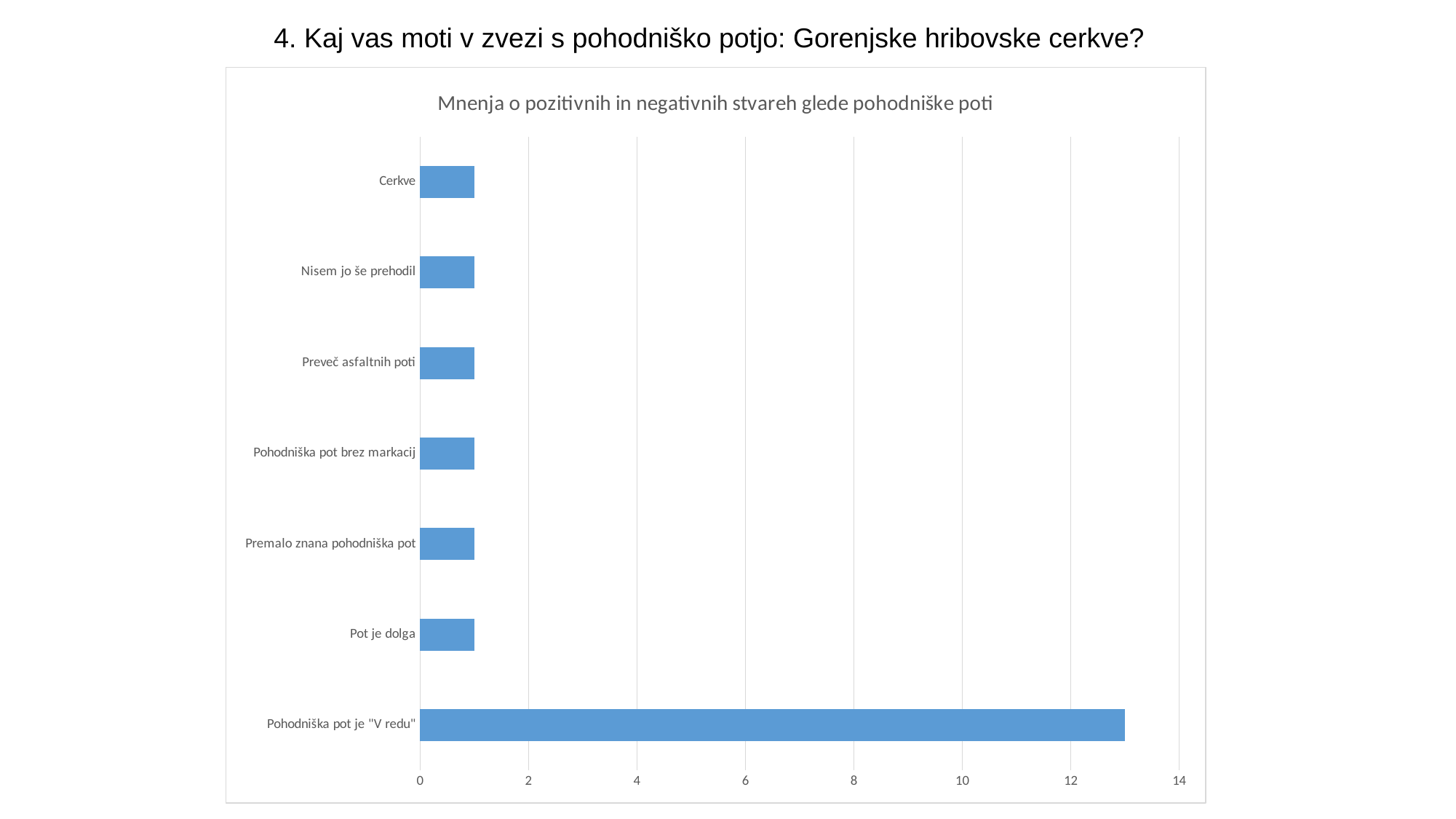
Is the value for Pot je dolga greater or less than 2? less Is the value for Cerkve greater or less than 2? less Is the value for Pohodniška pot je "V redu" greater or less than 12? greater Which category has the highest value in the chart? Pohodniška pot je "V redu" What is the highest value shown on the horizontal axis of the chart? 14 Which is larger, the value for Pohodniška pot je "V redu" or the value for Preveč asfaltnih poti? Pohodniška pot je "V redu" What kind of chart is shown on the slide? bar chart Which is larger, the value for Pohodniška pot je "V redu" or the value for Nisem jo še prehodil? Pohodniška pot je "V redu" How many categories are plotted in the chart? 7 What is the title of the chart? Mnenja o pozitivnih in negativnih stvareh glede pohodniške poti